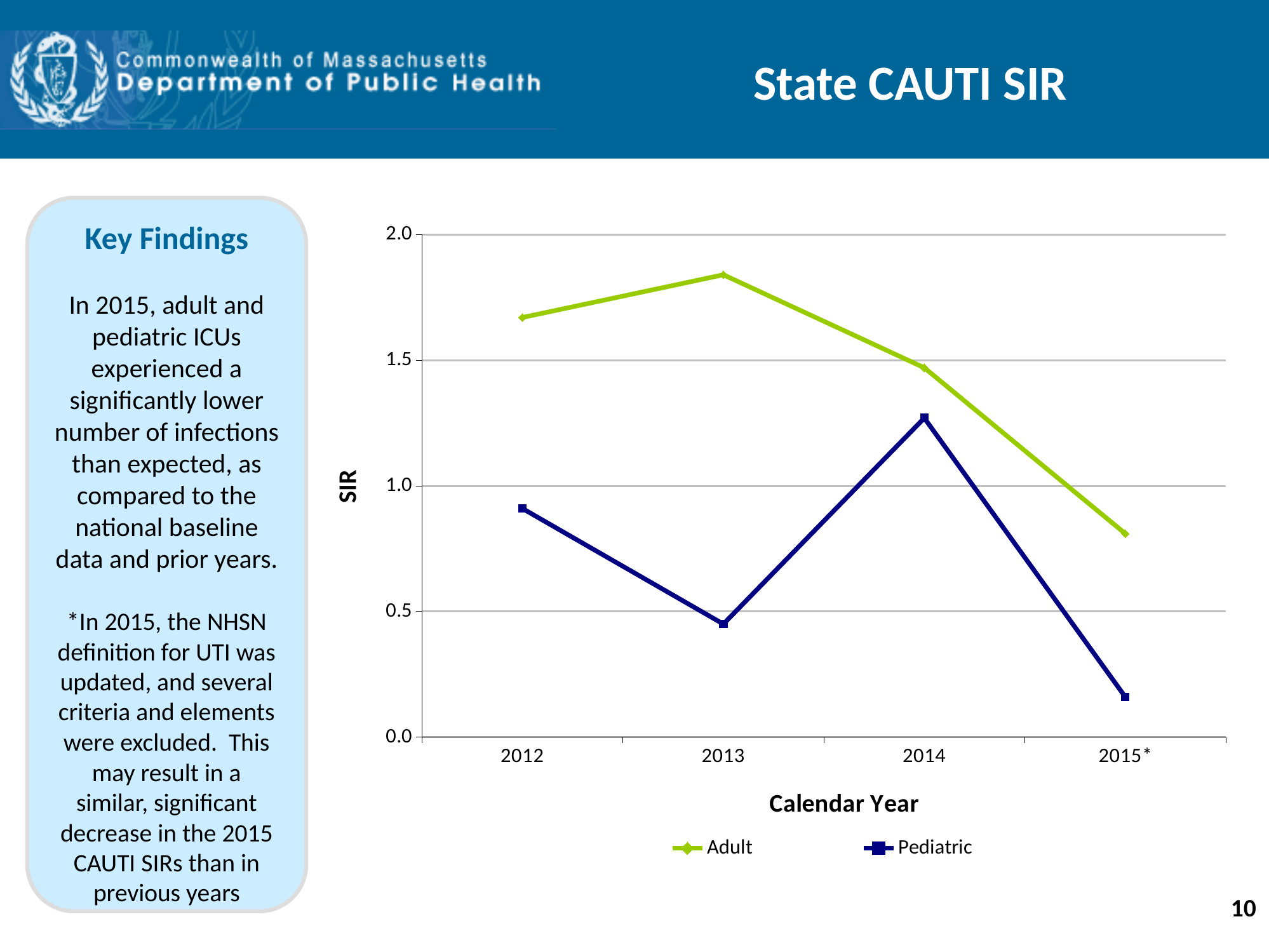
Does the Adult SIR rise or fall from 2013 to 2015*? fall In which year is the Adult SIR highest? 2013 Is the Pediatric SIR for 2013 greater or less than 0.5? less What kind of chart is shown on the slide? line chart How many calendar years are plotted on the x axis? 4 In which year is the Pediatric SIR highest? 2014 How many series does the legend list? 2 In which year is the Pediatric SIR lowest? 2015* Which series has the larger SIR in 2014, Adult or Pediatric? Adult What is the label of the y axis? SIR Is the Adult SIR for 2015* greater or less than 1.0? less Is the Adult SIR for 2013 greater or less than 1.5? greater